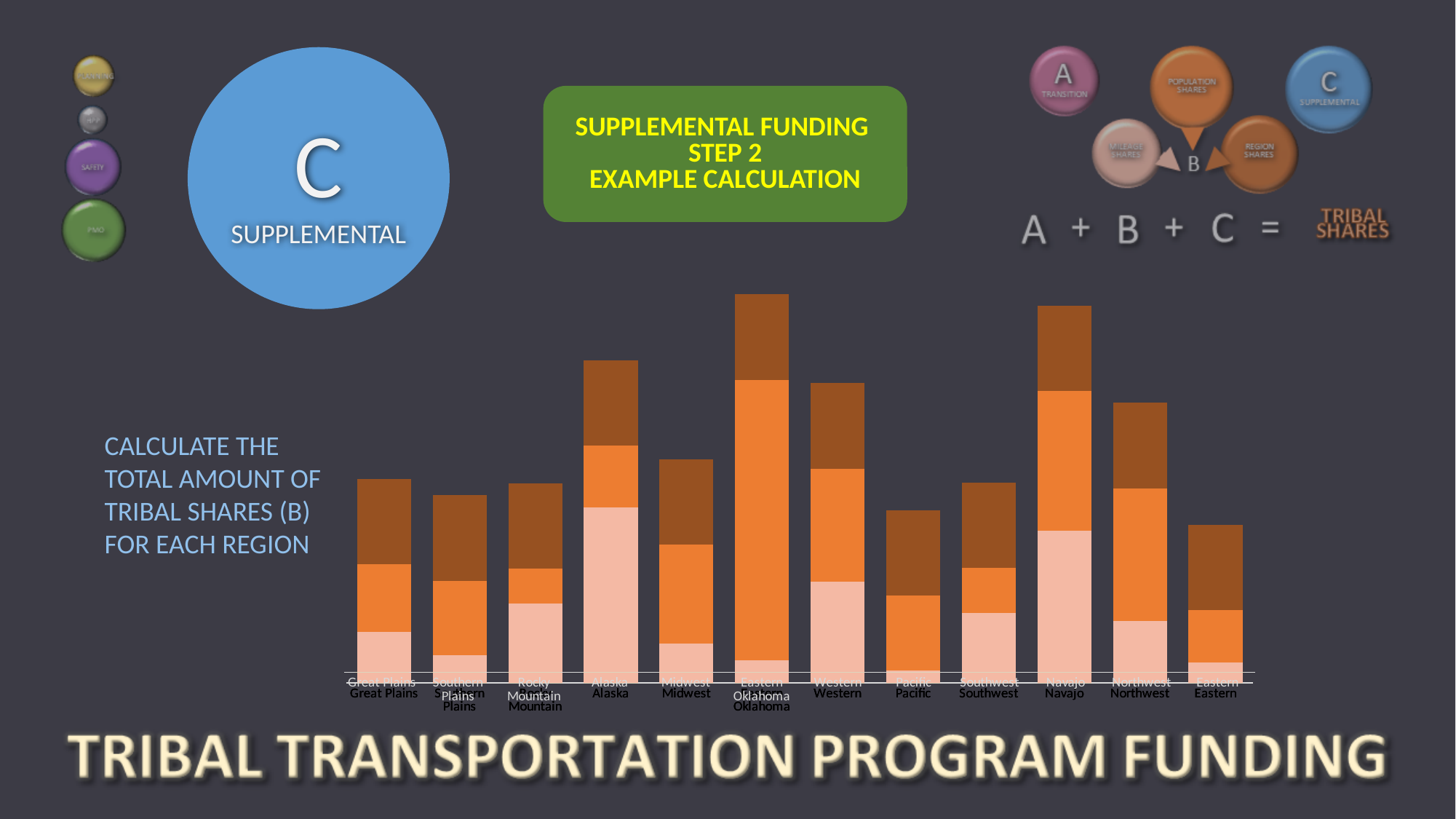
Which region is the leftmost category on the chart's x axis? Great Plains How many stacked segments make up each bar in the chart? 3 Which bar is taller overall, Western or Pacific? Western How many regions are shown along the x axis of the chart? 12 Which region's bar is taller, Great Plains or Eastern? Great Plains Which bar is taller overall, Eastern Oklahoma or Southwest? Eastern Oklahoma Which region has the largest bottom (lightest-coloured) segment in its bar? Alaska What kind of chart is shown on the slide? Stacked bar chart Which region is the rightmost category on the chart's x axis? Eastern